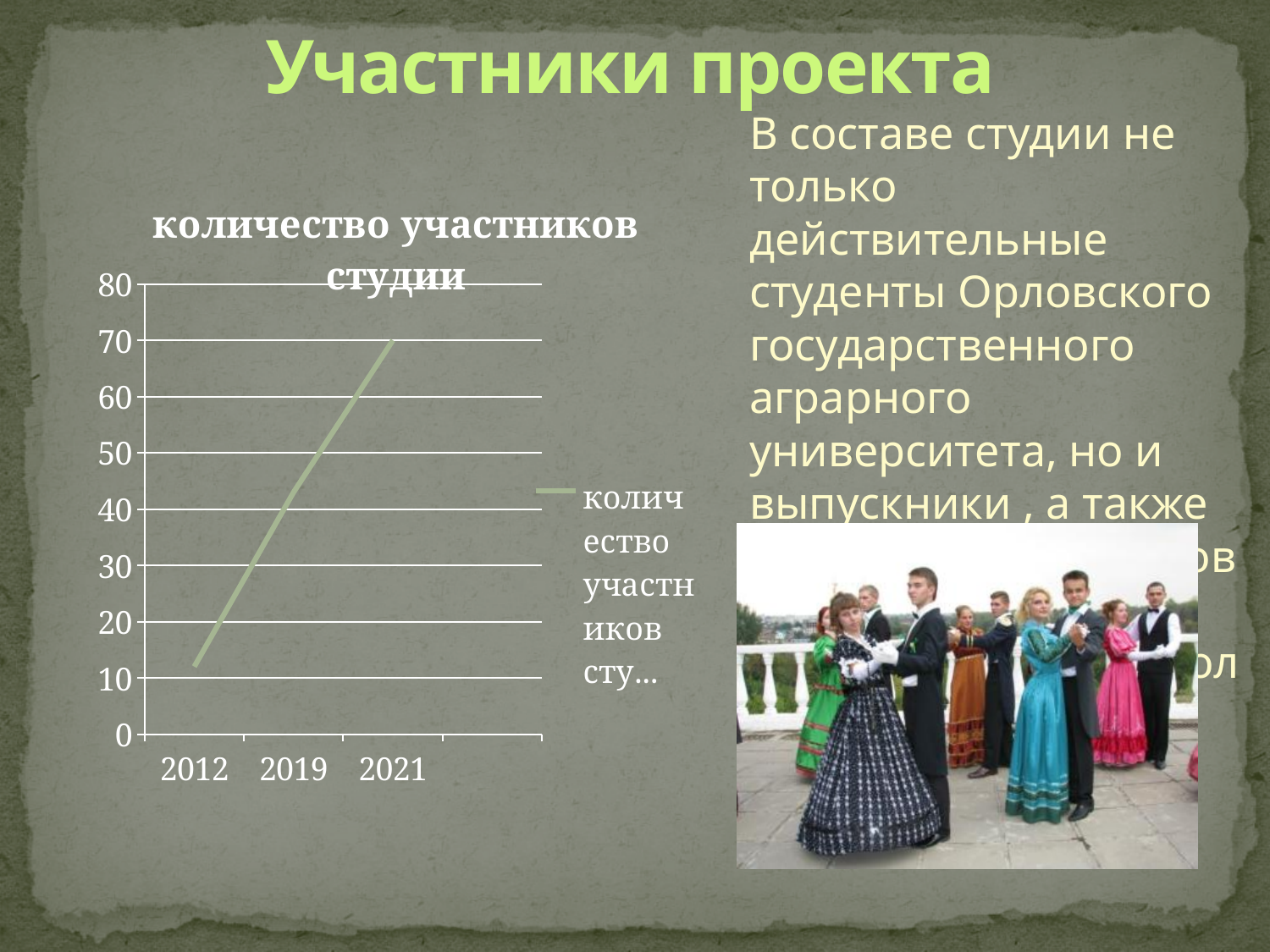
Which year has the lowest number of participants? 2012 How many series does the chart's legend list? 1 Do the values rise or fall from 2012 to 2021? rise What kind of chart is shown on the slide? line chart Which year has the highest number of participants? 2021 Is the value for 2012 greater or less than 20? less Is the value for 2019 greater or less than 30? greater Is the value for 2021 greater or less than 60? greater Which is larger, the value for 2019 or the value for 2021? 2021 What is the title of the chart? количество участников студии How many years are plotted on the x axis of the chart? 3